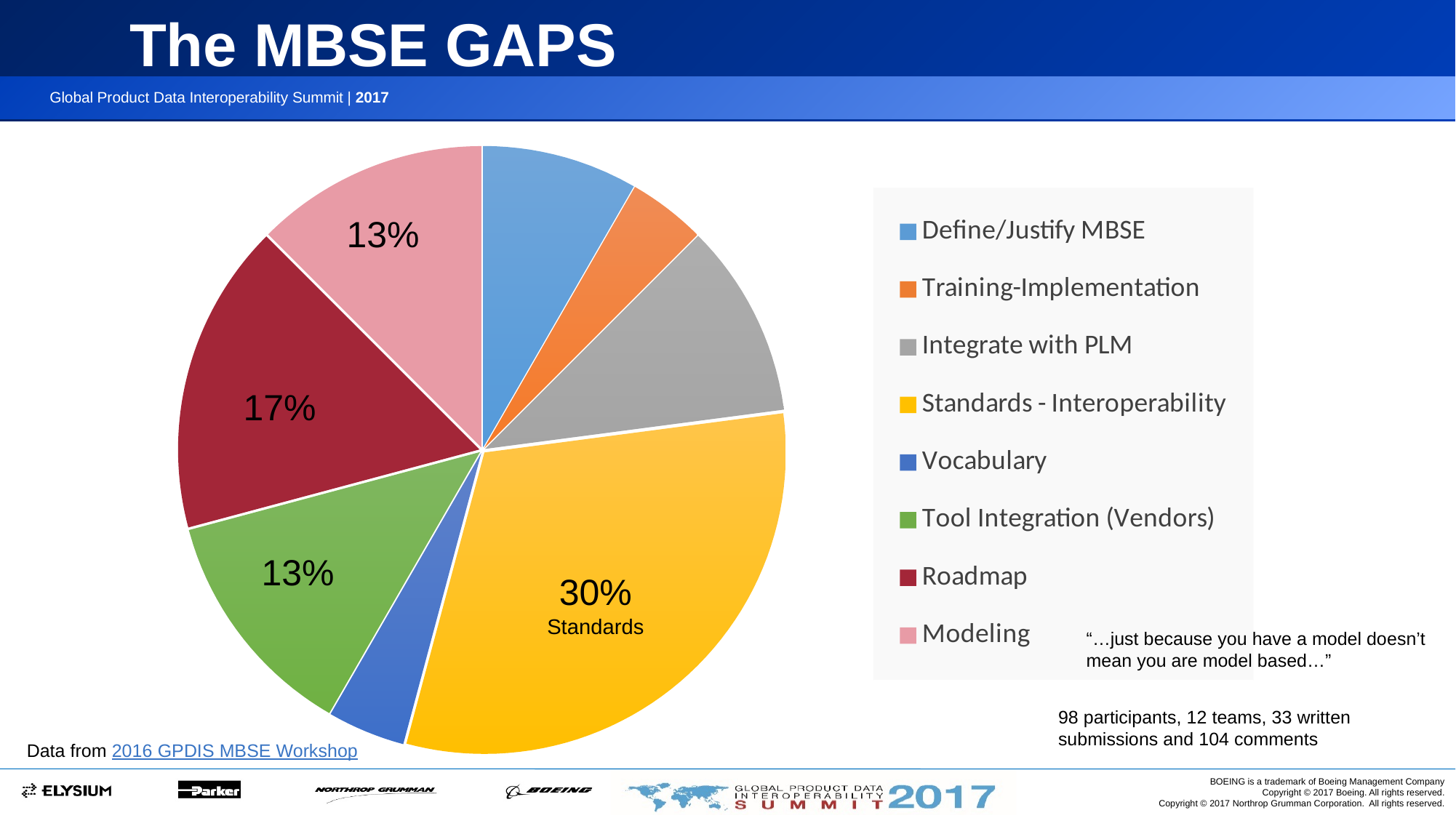
What kind of chart is shown on the slide? pie chart What percentage is shown for the Modeling slice? 13% What percentage is shown for the Tool Integration (Vendors) slice? 13% Which is larger, the Roadmap slice or the Modeling slice? Roadmap What colour is the Standards - Interoperability slice? yellow How many categories does the legend of the pie chart list? 8 What is the difference in percentage points between the Roadmap slice and the Tool Integration (Vendors) slice? 4 What is the difference in percentage points between the Standards - Interoperability slice and the Roadmap slice? 13 What percentage is shown for the Roadmap slice? 17% What percentage is shown for the Standards - Interoperability slice? 30% Which category has the largest slice of the pie? Standards - Interoperability Which legend entry is shown in pink? Modeling